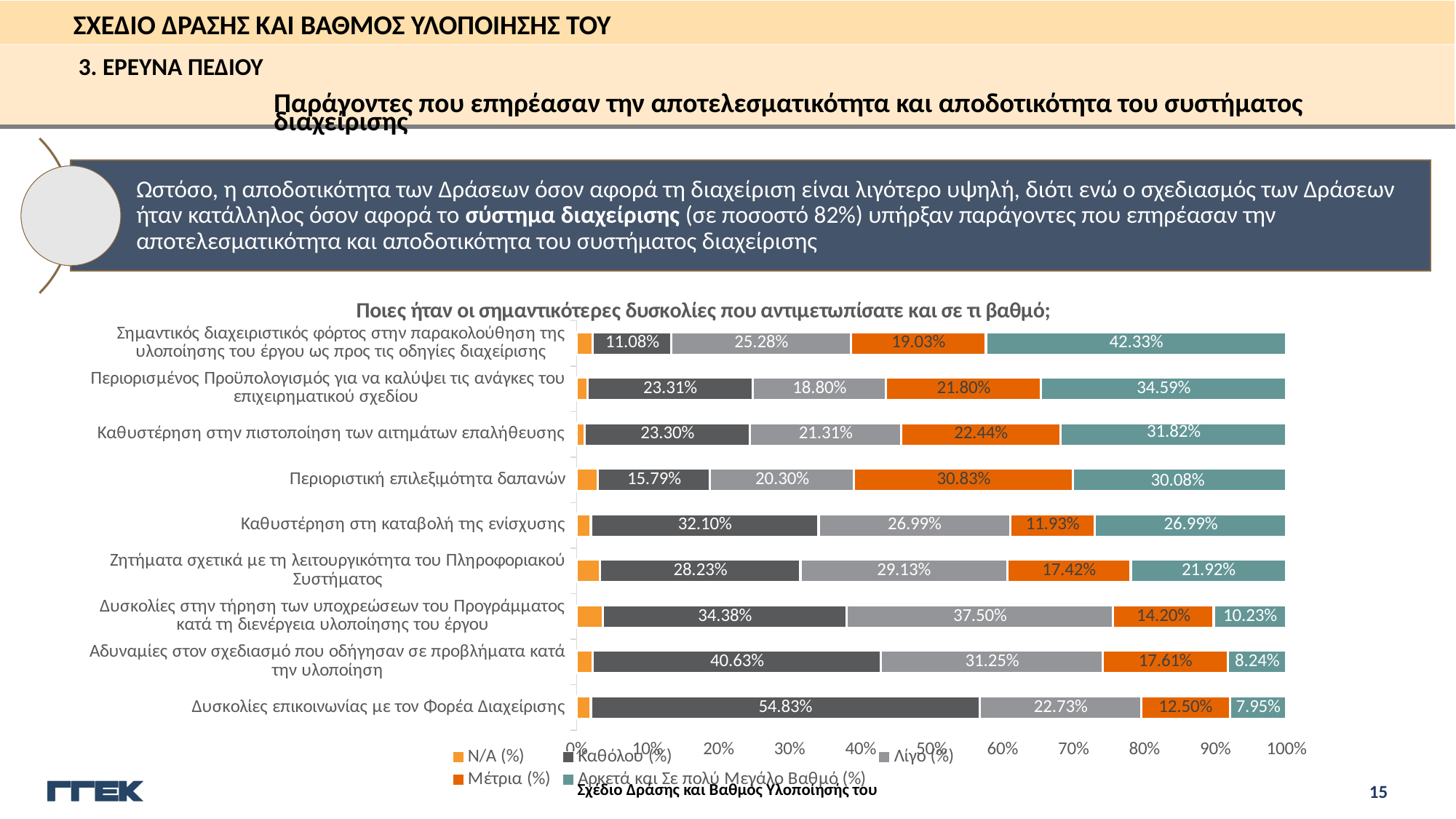
What is the 'Αρκετά και Σε πολύ Μεγάλο Βαθμό (%)' value for 'Σημαντικός διαχειριστικός φόρτος στην παρακολούθηση της υλοποίησης του έργου ως προς τις οδηγίες διαχείρισης'? 42.33% What type of chart is shown on the slide? Stacked bar chart Which category has the highest 'Καθόλου (%)' value? Δυσκολίες επικοινωνίας με τον Φορέα Διαχείρισης What is the 'Μέτρια (%)' value for 'Περιοριστική επιλεξιμότητα δαπανών'? 30.83% What is the 'Καθόλου (%)' value for 'Δυσκολίες επικοινωνίας με τον Φορέα Διαχείρισης'? 54.83% Which category has the lowest 'Αρκετά και Σε πολύ Μεγάλο Βαθμό (%)' value? Δυσκολίες επικοινωνίας με τον Φορέα Διαχείρισης How many series does the chart legend list? 5 Which has the larger 'Λίγο (%)' value: 'Δυσκολίες στην τήρηση των υποχρεώσεων του Προγράμματος κατά τη διενέργεια υλοποίησης του έργου' or 'Αδυναμίες στον σχεδιασμό που οδήγησαν σε προβλήματα κατά την υλοποίηση'? Δυσκολίες στην τήρηση των υποχρεώσεων του Προγράμματος κατά τη διενέργεια υλοποίησης του έργου What is the difference in 'Καθόλου (%)' between 'Δυσκολίες επικοινωνίας με τον Φορέα Διαχείρισης' and 'Αδυναμίες στον σχεδιασμό που οδήγησαν σε προβλήματα κατά την υλοποίηση'? 14.20 percentage points What is the title of the chart? Ποιες ήταν οι σημαντικότερες δυσκολίες που αντιμετωπίσατε και σε τι βαθμό; What is the 'Λίγο (%)' value for 'Καθυστέρηση στη καταβολή της ενίσχυσης'? 26.99% How many difficulty categories are plotted in the chart? 9